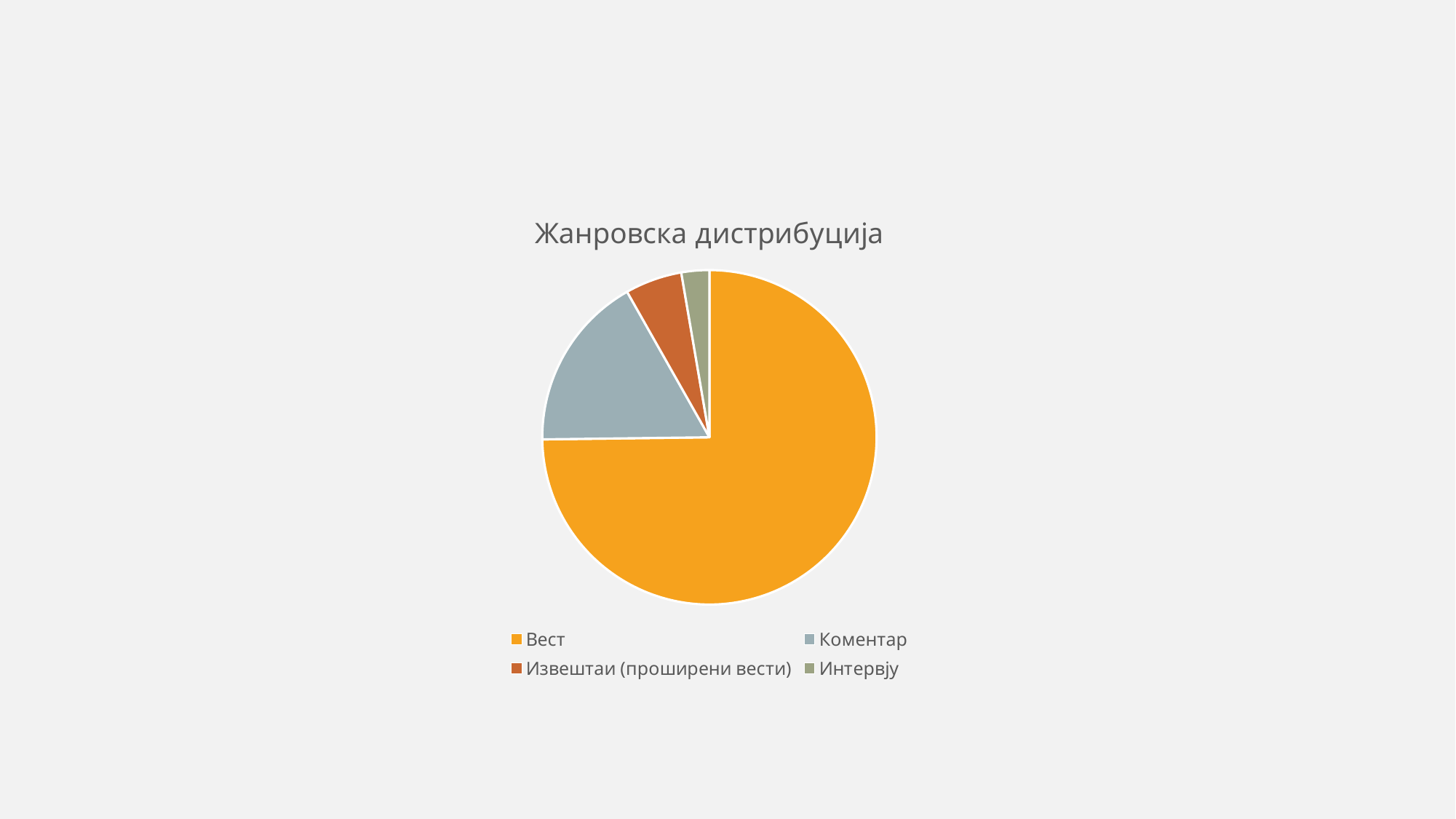
Which category has the smallest slice of the pie? Интервју Which category has the second-largest slice of the pie? Коментар How many categories (slices) does the pie chart have? 4 Which category is shown in orange in the legend? Вест Does the Вест slice take up more or less than half of the pie? more Which category has the largest slice of the pie? Вест What kind of chart is shown on the slide? pie chart What is the title of the chart? Жанровска дистрибуција Which slice is larger, Вест or Коментар? Вест Which slice is larger, Извештаи (проширени вести) or Интервју? Извештаи (проширени вести) Which slice is larger, Коментар or Извештаи (проширени вести)? Коментар